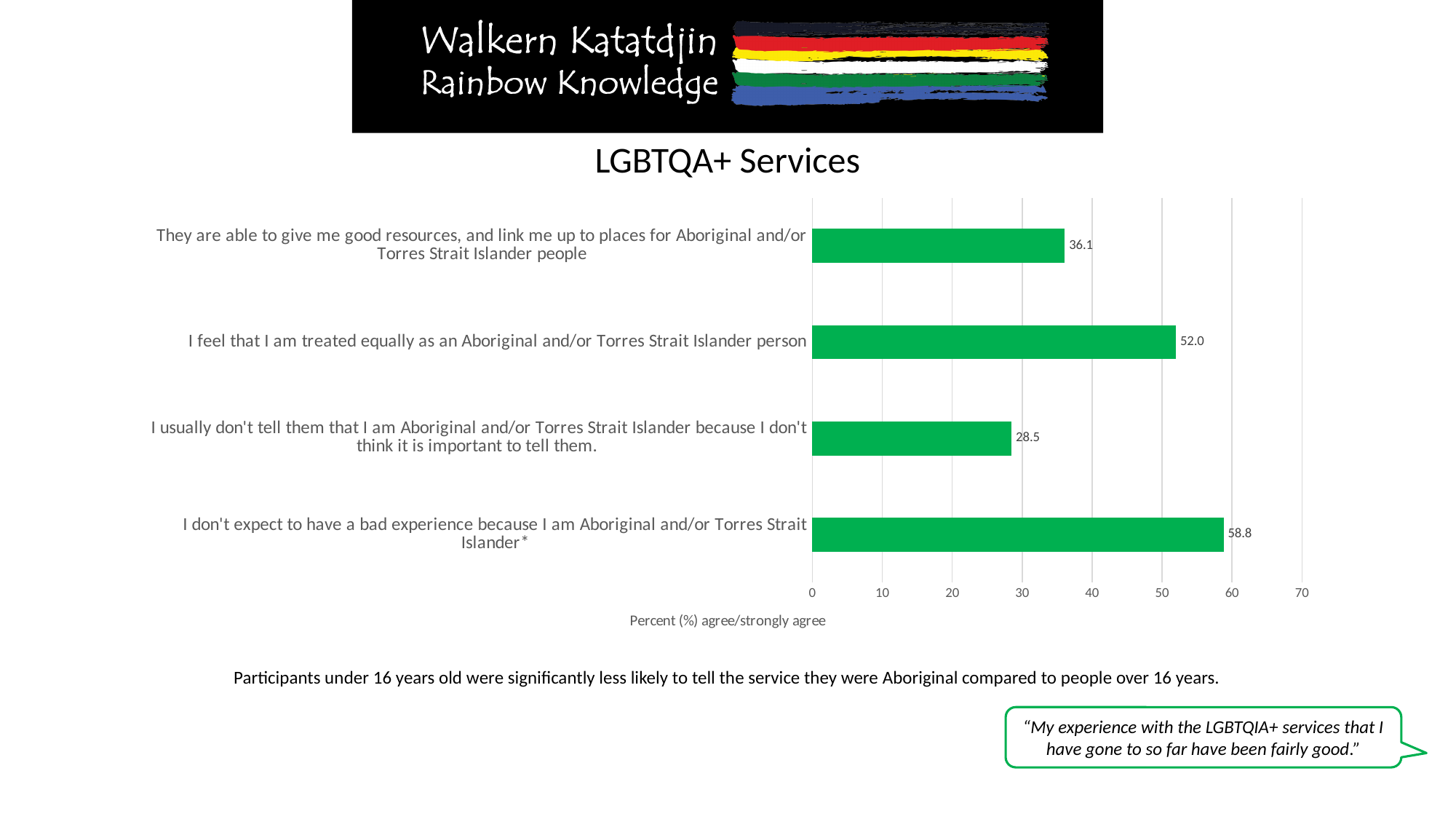
Which statement has the lowest percentage of agree/strongly agree? I usually don't tell them that I am Aboriginal and/or Torres Strait Islander because I don't think it is important to tell them. Which statement has the highest percentage of agree/strongly agree? I don't expect to have a bad experience because I am Aboriginal and/or Torres Strait Islander* Is the value for "I feel that I am treated equally as an Aboriginal and/or Torres Strait Islander person" greater or less than 50? greater What is the value for "I don't expect to have a bad experience because I am Aboriginal and/or Torres Strait Islander*"? 58.8 What is the difference between the values for "I don't expect to have a bad experience because I am Aboriginal and/or Torres Strait Islander*" and "I feel that I am treated equally as an Aboriginal and/or Torres Strait Islander person"? 6.8 How many statements (bars) are shown in the chart? 4 What kind of chart is shown on the slide? bar chart What is the title of the chart? LGBTQA+ Services What is the value for "I usually don't tell them that I am Aboriginal and/or Torres Strait Islander because I don't think it is important to tell them."? 28.5 What is the value for "They are able to give me good resources, and link me up to places for Aboriginal and/or Torres Strait Islander people"? 36.1 What is the value for "I feel that I am treated equally as an Aboriginal and/or Torres Strait Islander person"? 52.0 Which is larger: the value for "They are able to give me good resources, and link me up to places for Aboriginal and/or Torres Strait Islander people" or the value for "I usually don't tell them that I am Aboriginal and/or Torres Strait Islander because I don't think it is important to tell them."? They are able to give me good resources, and link me up to places for Aboriginal and/or Torres Strait Islander people